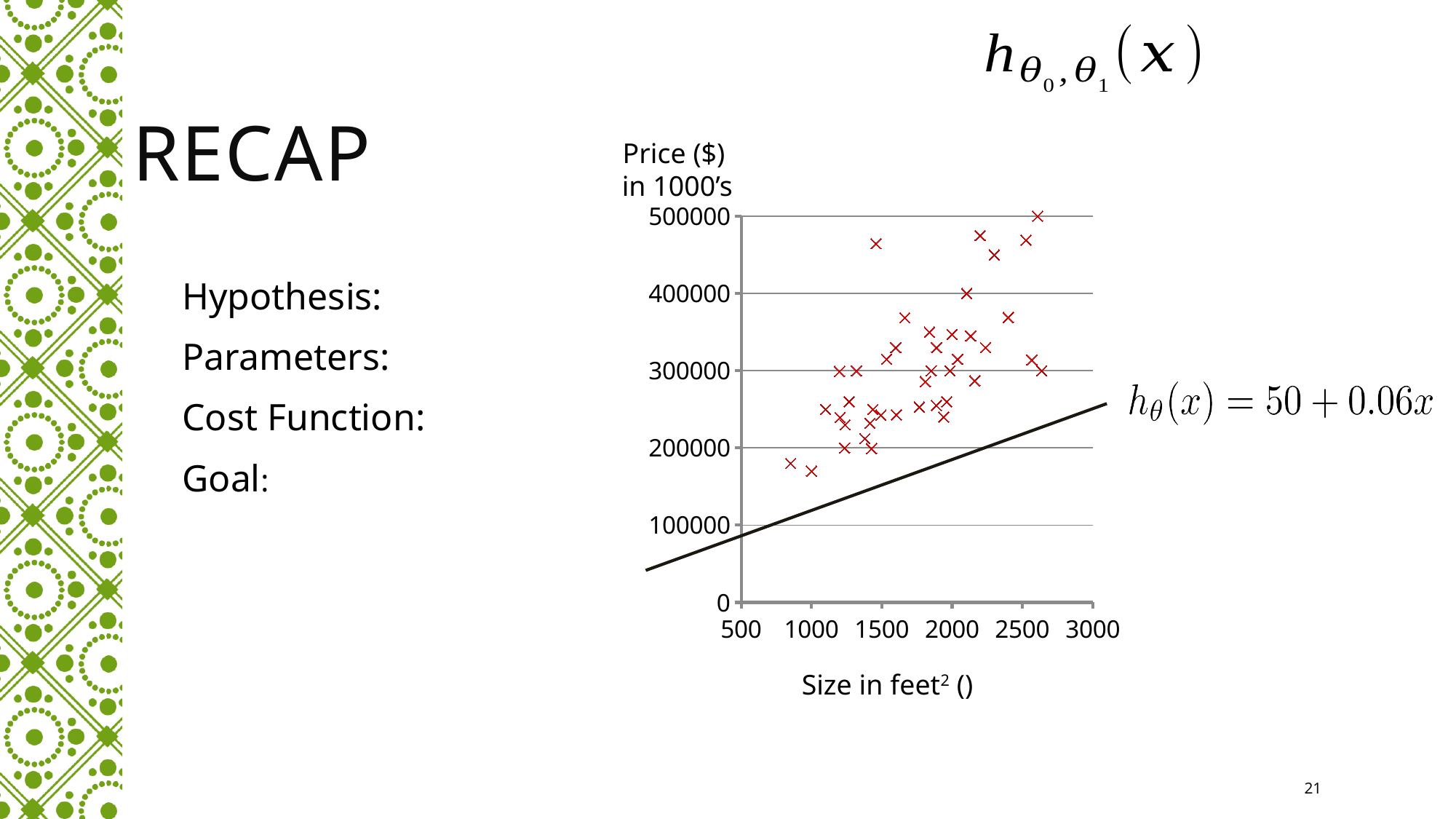
What is the highest value shown on the y axis? 500000 Is the price for the data point near size 1450 at the top of the cluster greater or less than 400000? greater What kind of chart is shown on the slide? scatter plot Which is larger: the price of the data point near size 850 or the price of the highest data point near size 2600? the point near size 2600 Is the price for the leftmost data point (near size 850) greater or less than 200000? less What is the label of the x axis of the chart? Size in feet2 () What is the label of the y axis of the chart? Price ($) in 1000's Is the price for the data point near size 2400 greater or less than 300000? greater Do the plotted prices generally rise or fall as size increases along the x axis? rise Does the fitted line drawn on the chart rise or fall from left to right? rise